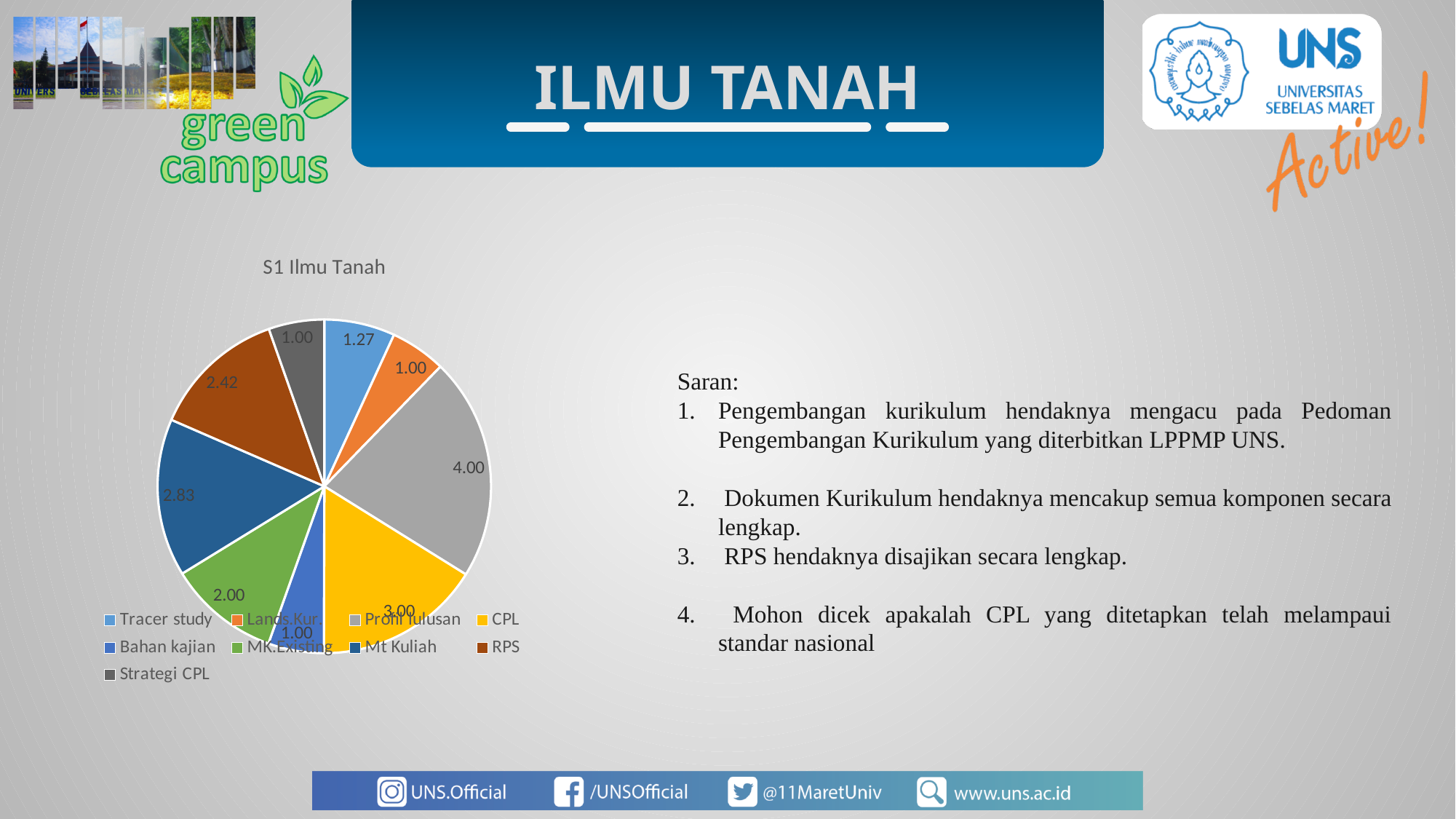
What is the value for Tracer study in the pie chart? 1.27 Which category has the largest slice in the pie chart? Profil lulusan What is the value for Mt Kuliah in the pie chart? 2.83 What kind of chart is shown on the slide? pie chart What is the difference between the values for Profil lulusan and CPL? 1.00 Which is larger, the value for Mt Kuliah or the value for RPS? Mt Kuliah What is the title of the pie chart? S1 Ilmu Tanah What is the value for CPL in the pie chart? 3.00 What is the value for MK.Existing in the pie chart? 2.00 How many categories does the pie chart have? 9 What is the value for RPS in the pie chart? 2.42 What is the value for Profil lulusan in the pie chart? 4.00